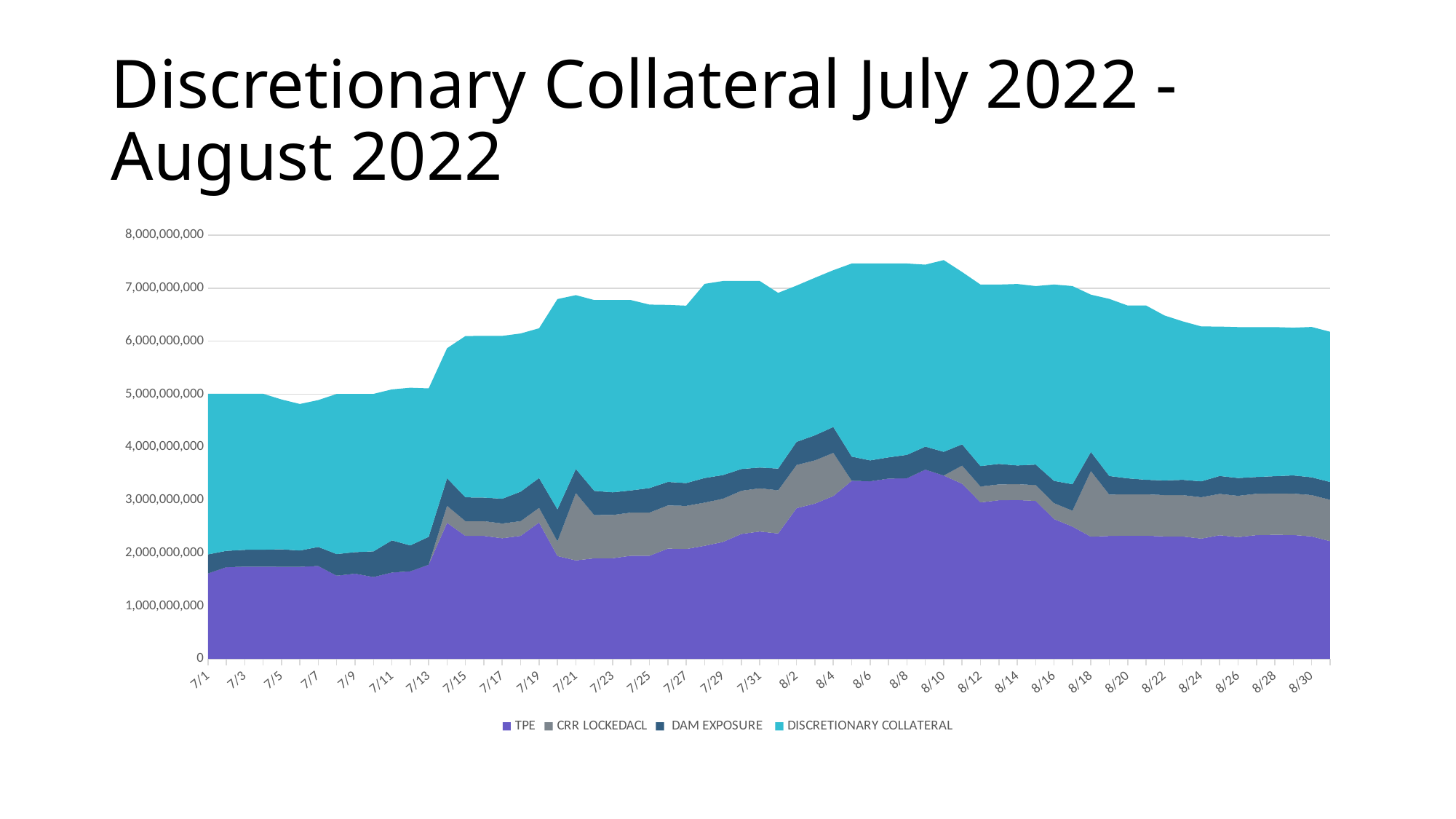
Is the stacked total on 7/21 greater or less than 7,000,000,000? less Which series is shown in purple at the bottom of the stack? TPE Is the TPE value on 7/1 greater or less than 2,000,000,000? less Around which date does the stacked total reach its highest point? 8/10 What is the title of the chart? Discretionary Collateral July 2022 - August 2022 Is the stacked total on 8/30 greater or less than 6,000,000,000? greater Does the stacked total rise or fall from 7/1 to 8/10? rise Does the stacked total rise or fall from 8/10 to 8/30? fall How many series does the legend list? 4 What kind of chart is shown on the slide? Stacked area chart